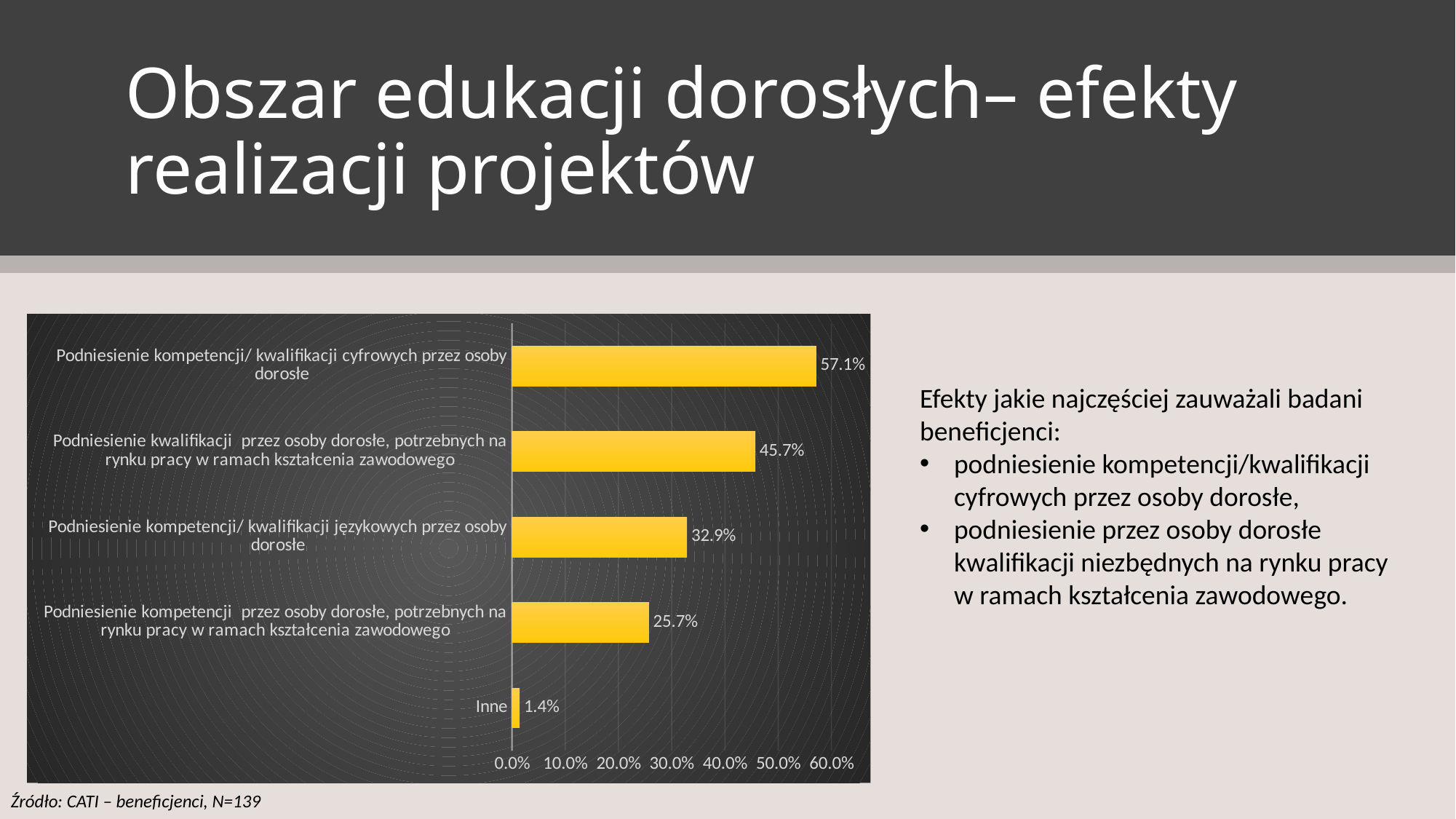
Which category has the lowest value? Inne Which category has the highest value? Podniesienie kompetencji/ kwalifikacji cyfrowych przez osoby dorosłe How many categories are shown in the chart? 5 What is the value for "Podniesienie kompetencji/ kwalifikacji językowych przez osoby dorosłe"? 32.9% What is the value for "Podniesienie kwalifikacji przez osoby dorosłe, potrzebnych na rynku pracy w ramach kształcenia zawodowego"? 45.7% What is the value for "Inne"? 1.4% What kind of chart is shown on the slide? bar chart What is the value for "Podniesienie kompetencji/ kwalifikacji cyfrowych przez osoby dorosłe"? 57.1% Which is larger: the value for "Podniesienie kompetencji/ kwalifikacji językowych przez osoby dorosłe" or for "Podniesienie kompetencji przez osoby dorosłe, potrzebnych na rynku pracy w ramach kształcenia zawodowego"? Podniesienie kompetencji/ kwalifikacji językowych przez osoby dorosłe What colour are the bars in the chart? yellow What is the difference between the values for "Podniesienie kompetencji/ kwalifikacji cyfrowych przez osoby dorosłe" and "Podniesienie kwalifikacji przez osoby dorosłe, potrzebnych na rynku pracy w ramach kształcenia zawodowego"? 11.4% Is the value for "Podniesienie kompetencji przez osoby dorosłe, potrzebnych na rynku pracy w ramach kształcenia zawodowego" greater or less than 30.0%? less